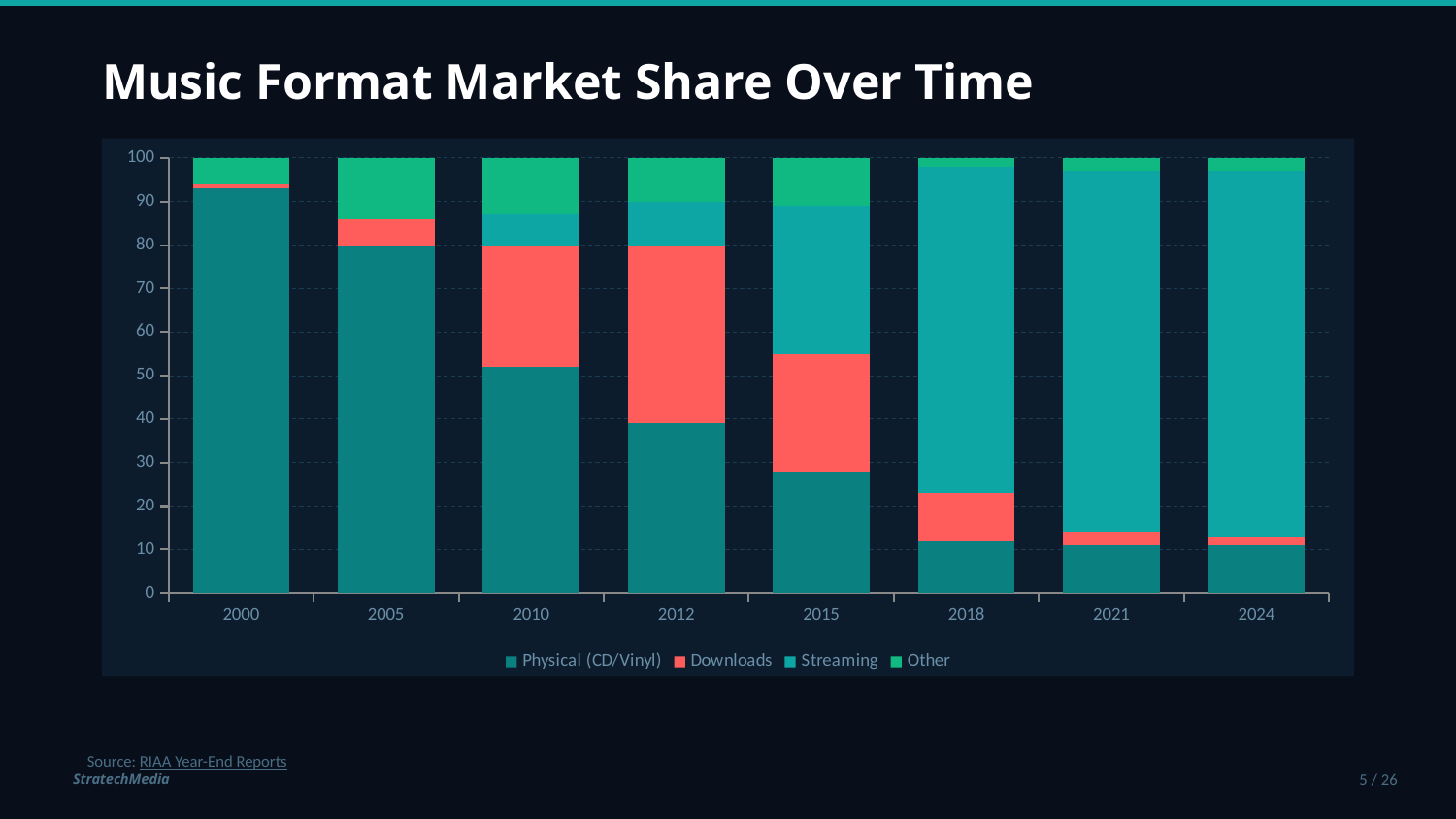
What kind of chart is shown on the slide? Stacked bar chart In which year is the Downloads segment the largest? 2012 What is the title of the chart on the slide? Music Format Market Share Over Time Does the Physical (CD/Vinyl) share rise or fall from 2000 to 2024? Fall Which is larger: the Physical (CD/Vinyl) segment in 2005 or in 2012? 2005 How many series does the chart's legend list? 4 What is the total height of the stacked bar for 2000? 100 In which year is the Physical (CD/Vinyl) segment the largest? 2000 Is the Physical (CD/Vinyl) value for 2000 greater or less than 90? greater Is the Physical (CD/Vinyl) value for 2015 greater or less than 30? less Which series is shown in red in the chart? Downloads How many years are shown on the x axis of the chart? 8